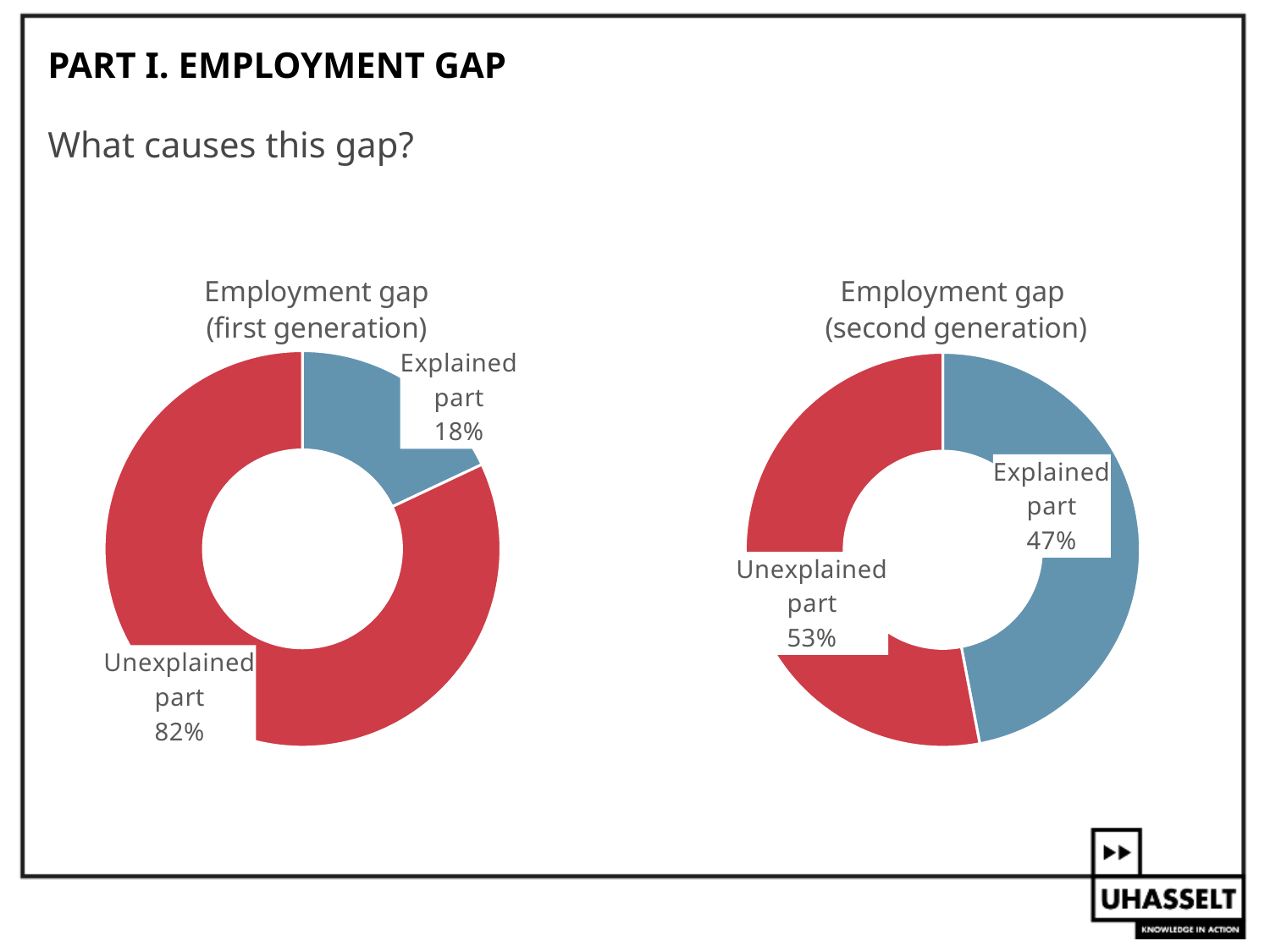
In the 'Employment gap (first generation)' chart, what is the difference between the Unexplained part and the Explained part? 64% Is the Explained part larger in the 'Employment gap (first generation)' chart or in the 'Employment gap (second generation)' chart? Employment gap (second generation) In the 'Employment gap (first generation)' chart, what is the value for the Unexplained part? 82% How many slices does the 'Employment gap (second generation)' chart have? 2 In the 'Employment gap (second generation)' chart, what is the difference between the Unexplained part and the Explained part? 6% In the 'Employment gap (second generation)' chart, which part is the smallest? Explained part In the 'Employment gap (first generation)' chart, what is the value for the Explained part? 18% In the 'Employment gap (second generation)' chart, what is the value for the Unexplained part? 53% In the 'Employment gap (second generation)' chart, what is the value for the Explained part? 47% What kind of chart is the 'Employment gap (first generation)' chart? Doughnut (pie) chart In the 'Employment gap (first generation)' chart, what colour is the Unexplained part slice? Red In the 'Employment gap (first generation)' chart, which part is the largest? Unexplained part